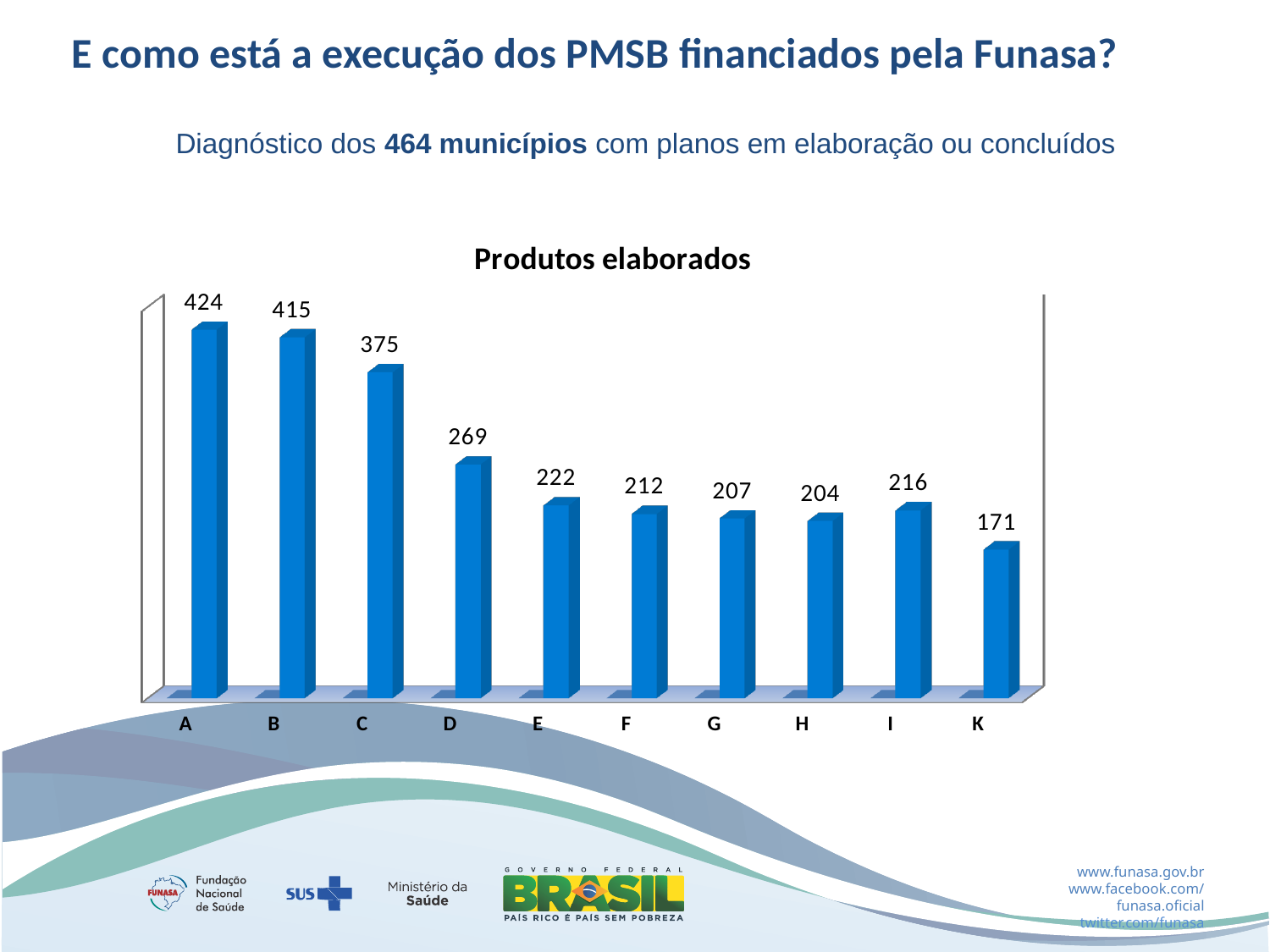
What is the title of the chart on the slide? Produtos elaborados What kind of chart is the Produtos elaborados chart? bar chart Do the values in the Produtos elaborados chart generally rise or fall from A to K? fall What is the difference between the values for C and D in the Produtos elaborados chart? 106 How many categories are shown in the Produtos elaborados chart? 10 Which is larger in the Produtos elaborados chart, the value for I or the value for H? I What is the difference between the values for A and B in the Produtos elaborados chart? 9 Which category has the highest value in the Produtos elaborados chart? A Which category has the lowest value in the Produtos elaborados chart? K What is the value for category A in the Produtos elaborados chart? 424 What is the value for category K in the Produtos elaborados chart? 171 What is the value for category D in the Produtos elaborados chart? 269